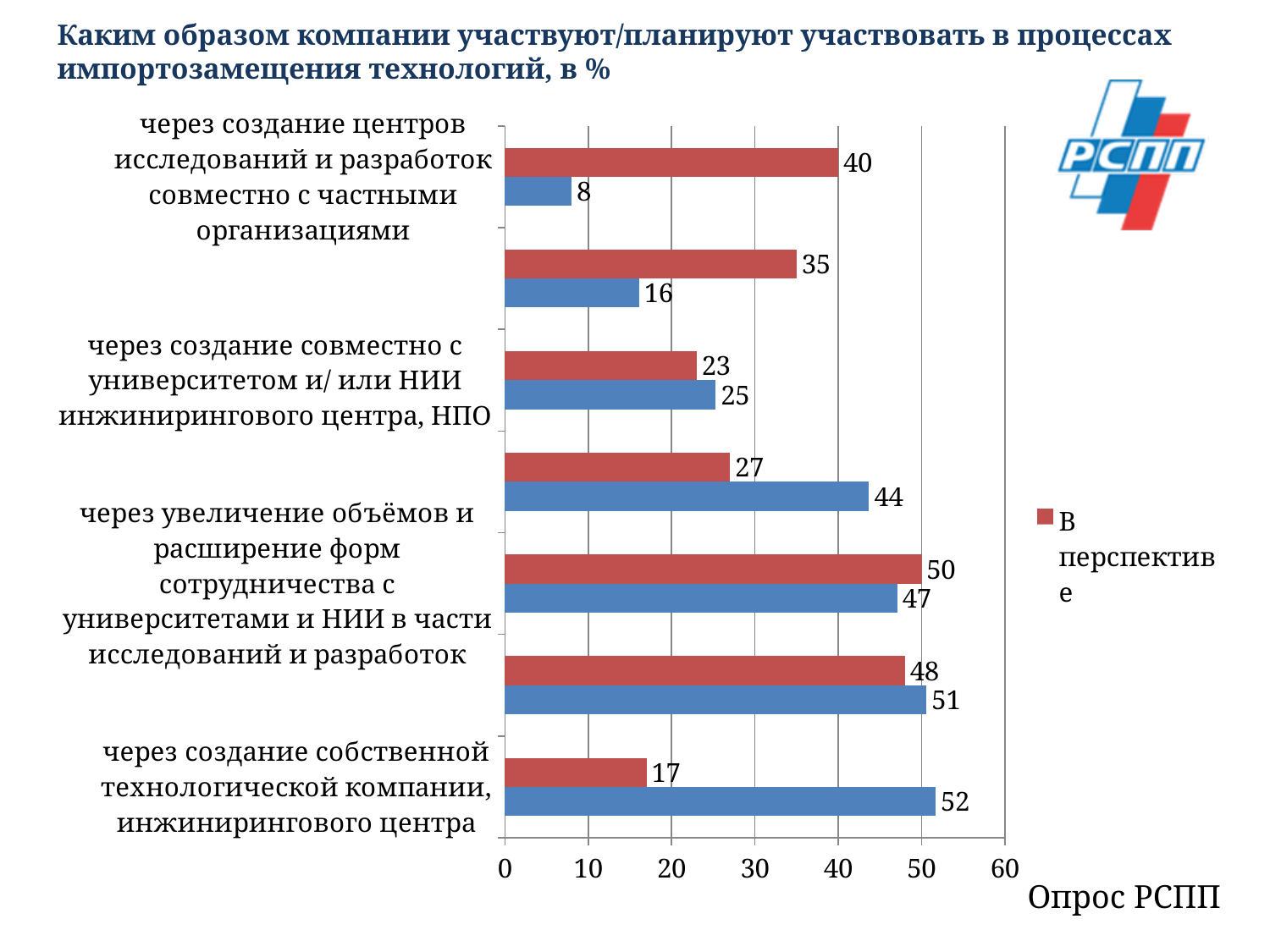
What is the value of the red bar (В перспективе) for 'через создание центров исследований и разработок совместно с частными организациями'? 40 What is the value of the blue bar for 'через создание центров исследований и разработок совместно с частными организациями'? 8 How many pairs of bars are plotted in the chart? 7 For 'через создание центров исследований и разработок совместно с частными организациями', how much larger is the red bar than the blue bar? 32 What is the value of the red bar (В перспективе) for 'через создание собственной технологической компании, инжинирингового центра'? 17 For 'через создание собственной технологической компании, инжинирингового центра', what is the difference between the blue bar and the red bar? 35 For 'через создание собственной технологической компании, инжинирингового центра', which bar is larger, the red one or the blue one? the blue one What is the largest value labelled on any bar in the chart? 52 What is the smallest value labelled on any bar in the chart? 8 What series name does the legend show for the red bars? В перспективе What type of chart is shown on the slide? bar chart What is the value of the blue bar for 'через создание собственной технологической компании, инжинирингового центра'? 52